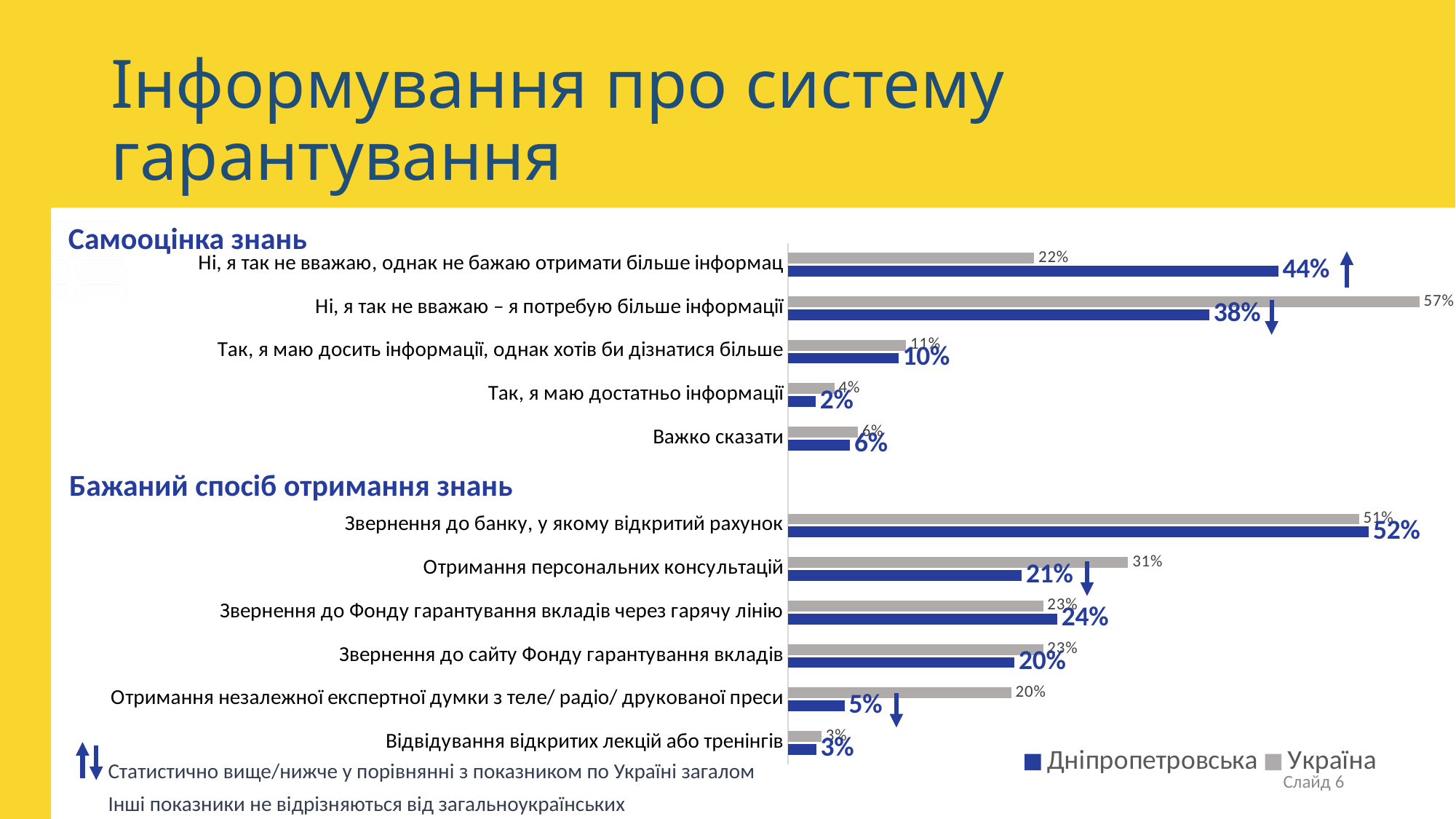
How many series does the chart legend list? 2 Which colour represents the Україна series in the chart? Grey How many categories are shown in the "Бажаний спосіб отримання знань" section of the chart? 6 What is the Дніпропетровська value for "Ні, я так не вважаю, однак не бажаю отримати більше інформац"? 44% What kind of chart is shown on the slide? Bar chart What is the Україна value for "Ні, я так не вважаю – я потребую більше інформації"? 57% Which category has the highest Дніпропетровська value? Звернення до банку, у якому відкритий рахунок What is the Україна value for "Отримання незалежної експертної думки з теле/ радіо/ друкованої преси"? 20% Which category has the lowest Дніпропетровська value? Так, я маю достатньо інформації What is the difference between the Україна and Дніпропетровська values for "Ні, я так не вважаю – я потребую більше інформації"? 19% What is the Дніпропетровська value for "Отримання персональних консультацій"? 21% For "Отримання незалежної експертної думки з теле/ радіо/ друкованої преси", which series has the larger value, Дніпропетровська or Україна? Україна